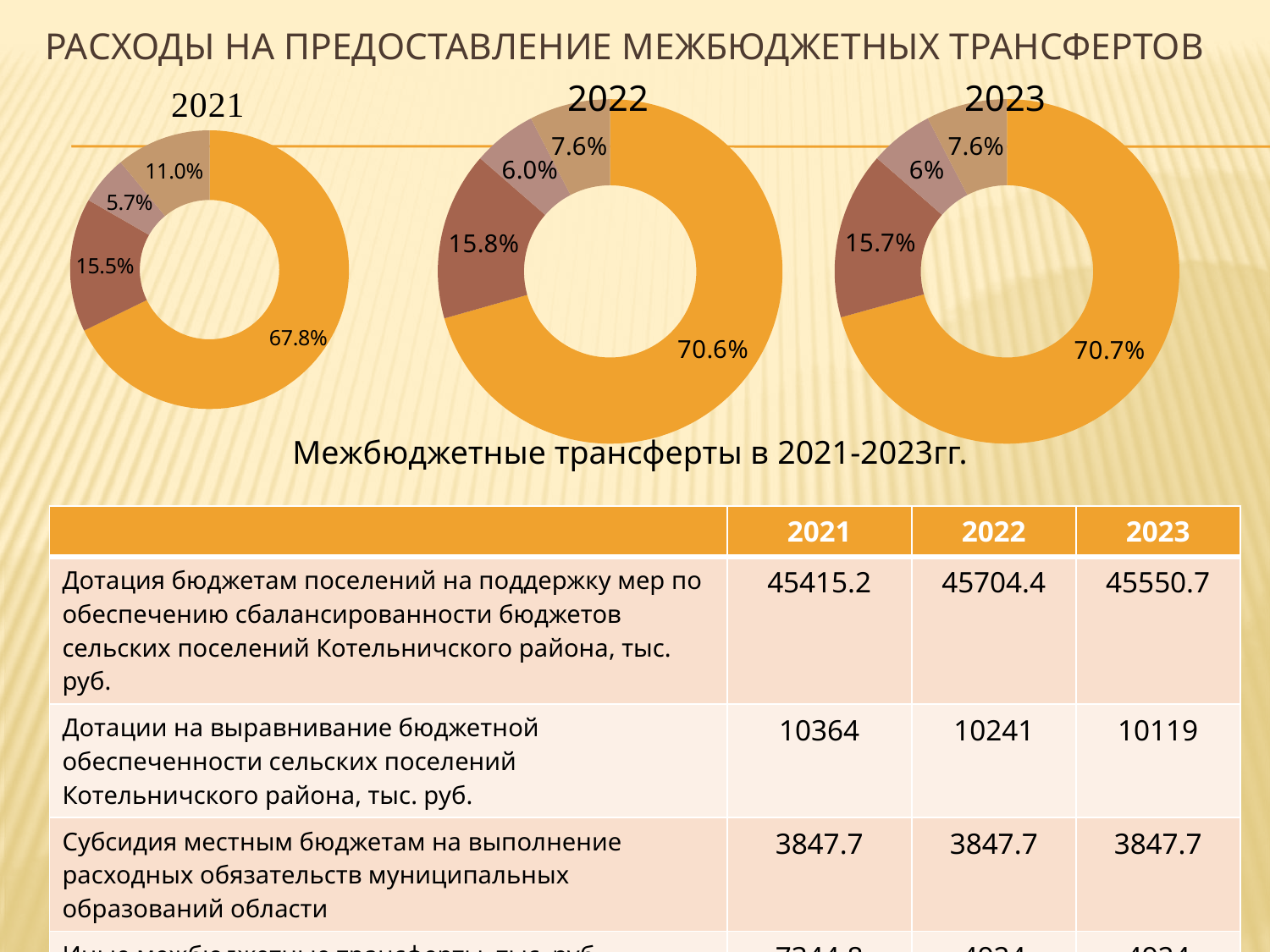
In the 2022 chart, what is the share of the smallest slice? 6.0% How many doughnut charts are shown on the slide? 3 In the 2021 chart, what is the share of the largest slice? 67.8% In the 2023 chart, what is the share of the second-largest slice? 15.7% How many slices does the 2023 chart have? 4 What is the title of the slide above the three charts? РАСХОДЫ НА ПРЕДОСТАВЛЕНИЕ МЕЖБЮДЖЕТНЫХ ТРАНСФЕРТОВ In the 2023 chart, what is the share of the largest slice? 70.7% In the 2021 chart, what is the difference between the largest slice (67.8%) and the second-largest slice (15.5%)? 52.3% Which is larger: the largest slice in the 2022 chart or the largest slice in the 2021 chart? 2022 chart (70.6%) In the 2021 chart, what is the share of the smallest slice? 5.7% What kind of chart is used for the 2021, 2022 and 2023 charts on the slide? doughnut chart In the 2022 chart, what is the share of the largest slice? 70.6%